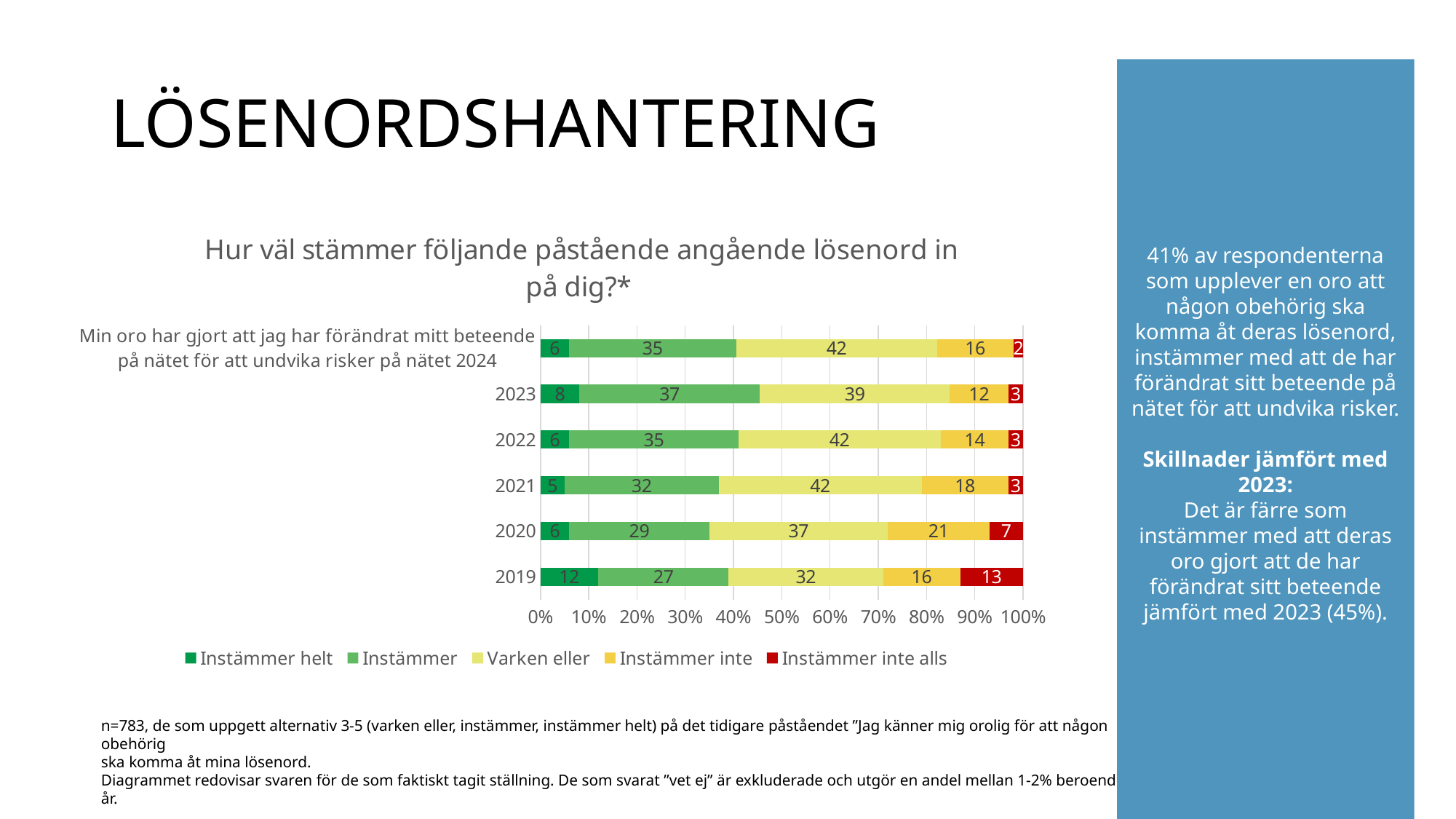
How many series does the legend list? 5 Which is larger: the "Instämmer helt" value for 2019 or for 2023? 2019 How many years are shown in the chart? 6 In which year is the "Instämmer inte" value lowest? 2023 Which colour represents "Instämmer inte alls" in the chart? Red What is the value for "Instämmer" in 2023? 37 What kind of chart is shown on the slide? Stacked bar chart What is the value for "Instämmer helt" in 2021? 5 What is the difference between the "Instämmer inte" values for 2020 and 2023? 9 What is the value for "Instämmer inte alls" in 2019? 13 What is the value for "Varken eller" in 2020? 37 In which year is the "Instämmer inte alls" value highest? 2019